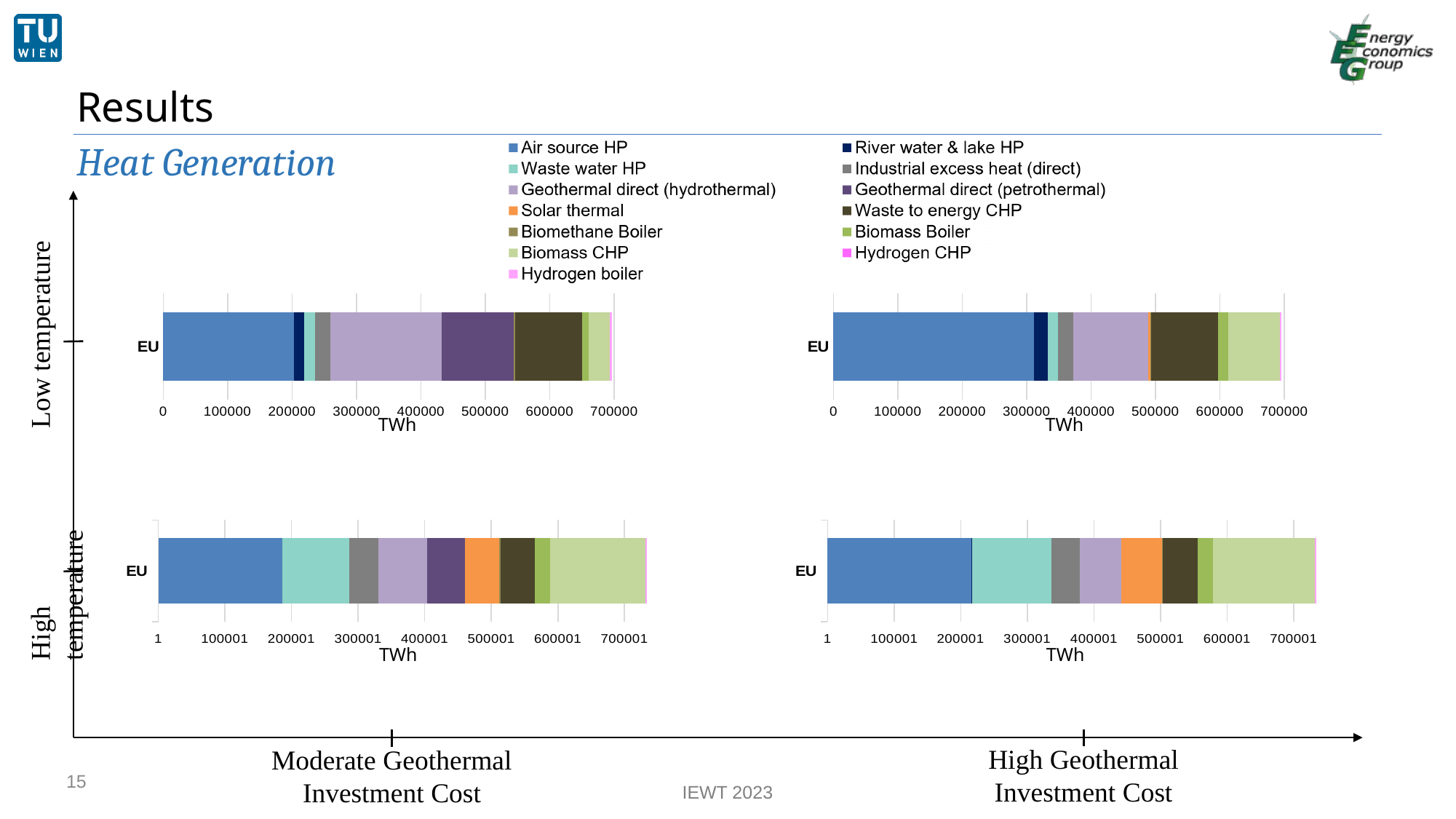
In the top-left chart (Low temperature, Moderate Geothermal Investment Cost), is the Air source HP segment for EU greater or less than 300000? less How many series does the shared legend list for the charts? 13 In the bottom-left chart (High temperature, Moderate Geothermal Investment Cost), which segment is larger for EU: Biomass CHP or Solar thermal? Biomass CHP In the top-right chart (Low temperature, High Geothermal Investment Cost), which series has the largest segment in the EU bar? Air source HP In the top-right chart (Low temperature, High Geothermal Investment Cost), is the Air source HP segment for EU greater or less than 200000? greater In the bottom-right chart (High temperature, High Geothermal Investment Cost), is the total length of the EU bar greater or less than 700001? greater What is the x-axis title of the bottom-left chart (High temperature, Moderate Geothermal Investment Cost)? TWh What colour does the legend use for Solar thermal? Orange In the top-left chart (Low temperature, Moderate Geothermal Investment Cost), which segment is larger for EU: Geothermal direct (hydrothermal) or Waste water HP? Geothermal direct (hydrothermal) How many categories are plotted on the y axis of the top-right chart (Low temperature, High Geothermal Investment Cost)? 1 What kind of chart is the top-left chart (Low temperature, Moderate Geothermal Investment Cost)? Stacked bar chart